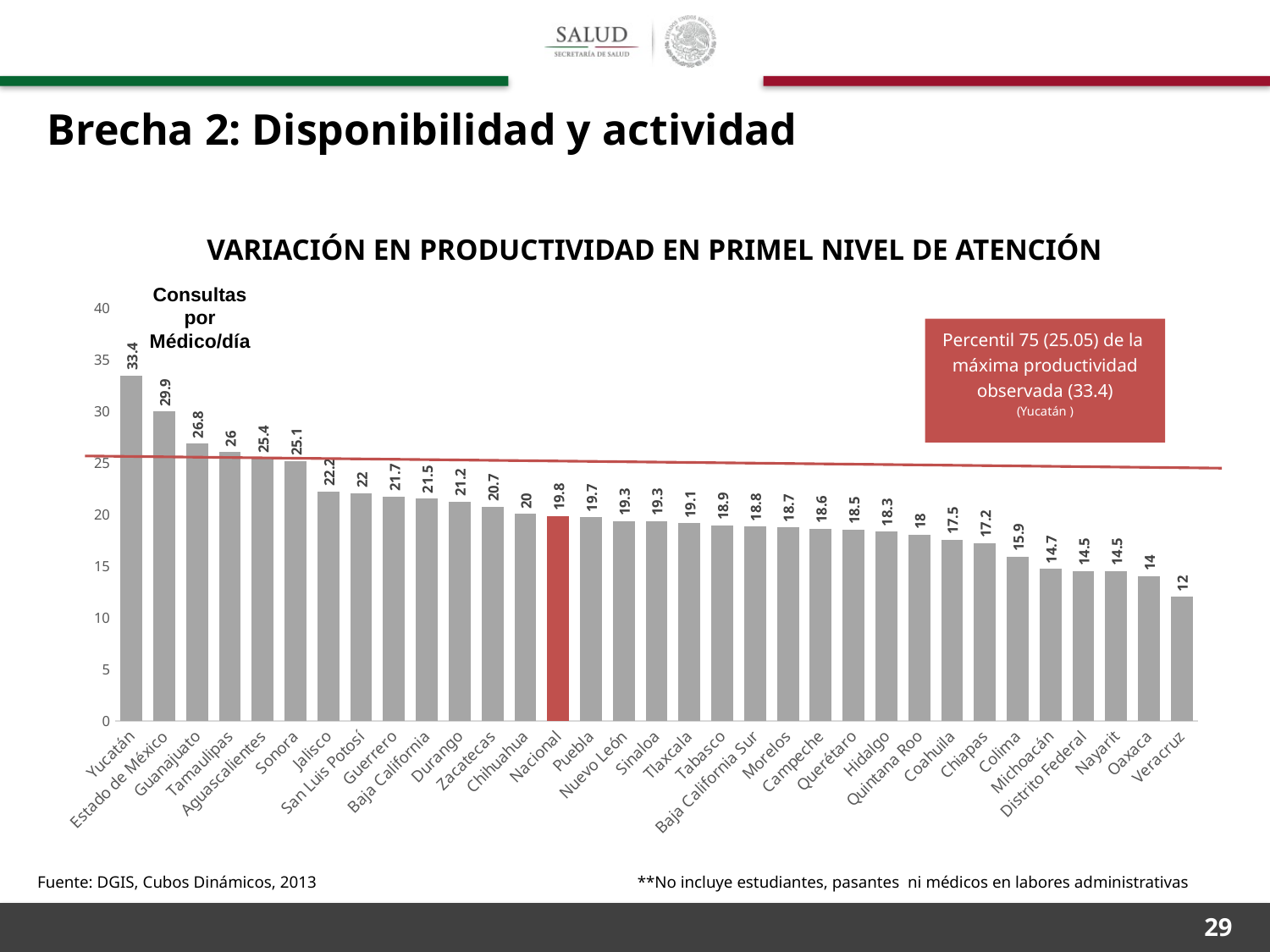
Which category has the lowest value? Veracruz What is the value for Veracruz? 12 What is the value for Nacional? 19.8 What is the value for Yucatán? 33.4 What kind of chart is shown on the slide? Bar chart What is the value for Chiapas? 17.2 How many bars are plotted in the chart? 33 What is the difference between the values for Yucatán and Veracruz? 21.4 Which category has the highest value? Yucatán Which has a larger value, Jalisco or Colima? Jalisco Do the values rise or fall from left to right along the x axis? Fall What is the difference between the values for Estado de México and Nacional? 10.1